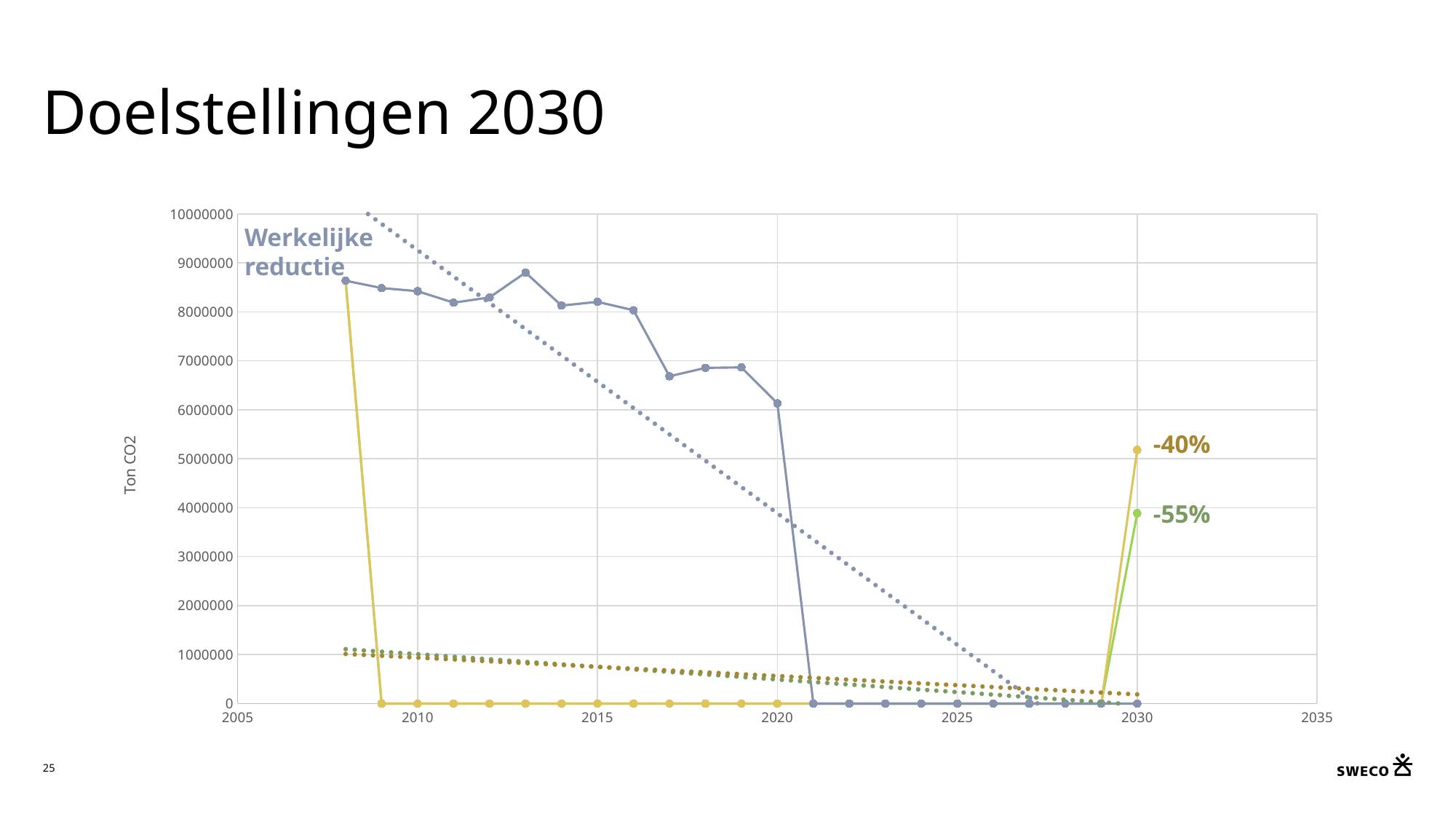
In 2030, which target point is higher: the -40% point or the -55% point? -40% Is the Werkelijke reductie value for 2017 greater or less than 7000000? less Is the Werkelijke reductie value for 2008 greater or less than 8000000? greater Is the -55% target point in 2030 greater or less than 5000000? less In which year does the Werkelijke reductie line reach its highest value? 2013 What kind of chart is shown on the slide? line chart What is the Werkelijke reductie value plotted for 2021? 0 What is the label on the vertical axis of the chart? Ton CO2 What is the title of the slide containing the chart? Doelstellingen 2030 Does the Werkelijke reductie line rise or fall overall between 2008 and 2020? fall